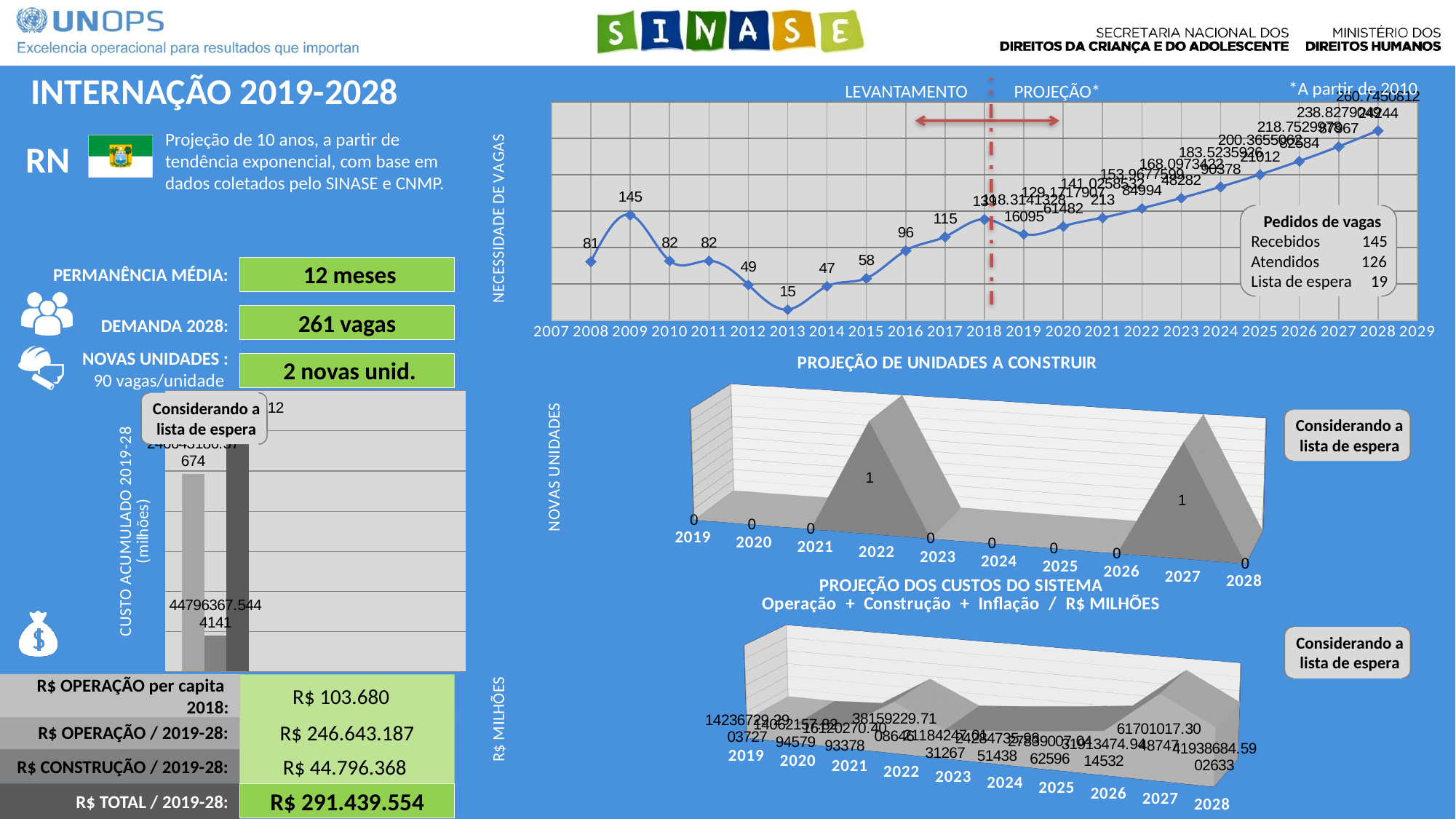
What kind of chart is the NECESSIDADE DE VAGAS chart? line chart In the NECESSIDADE DE VAGAS line chart, which is larger, the value for 2009 or the value for 2010? 2009 In the PROJEÇÃO DE UNIDADES A CONSTRUIR chart, what is the value for 2022? 1 In the NECESSIDADE DE VAGAS line chart, what is the value for 2017? 115 In the NECESSIDADE DE VAGAS line chart, which year has the lowest value? 2013 In the NECESSIDADE DE VAGAS line chart, what is the value for 2009? 145 In the NECESSIDADE DE VAGAS line chart, what is the value for 2016? 96 In the PROJEÇÃO DE UNIDADES A CONSTRUIR chart, what is the value for 2025? 0 In the NECESSIDADE DE VAGAS line chart, what is the difference between the values for 2009 and 2008? 64 In the NECESSIDADE DE VAGAS line chart, do the values rise or fall from 2019 to 2028? rise In the PROJEÇÃO DE UNIDADES A CONSTRUIR chart, how many years are shown on the x axis? 10 In the NECESSIDADE DE VAGAS line chart, what is the value for 2013? 15